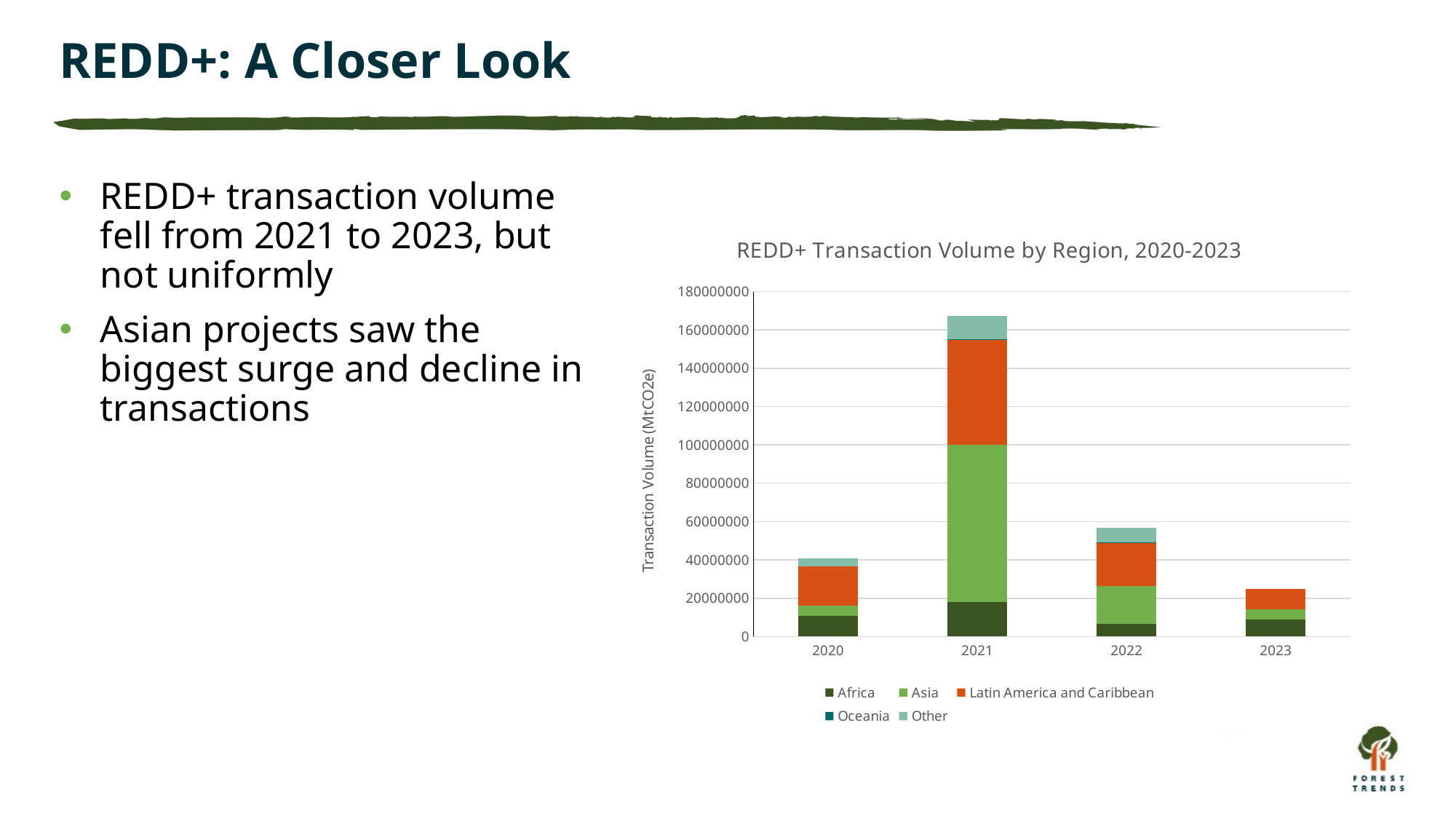
Is the total transaction volume for 2020 greater or less than 60000000? less Which region is represented by the orange segments in the chart? Latin America and Caribbean Is the total transaction volume for 2023 greater or less than 20000000? greater Which year has the lowest total REDD+ transaction volume? 2023 Is the total transaction volume for 2021 greater or less than 160000000? greater What is the title of the chart? REDD+ Transaction Volume by Region, 2020-2023 Which year has a larger total transaction volume, 2020 or 2022? 2022 How many years are shown on the x axis of the chart? 4 How many series does the chart's legend list? 5 Which year has the highest total REDD+ transaction volume? 2021 Does the total transaction volume rise or fall from 2021 to 2023? Fall What kind of chart is shown on the slide? Stacked bar chart